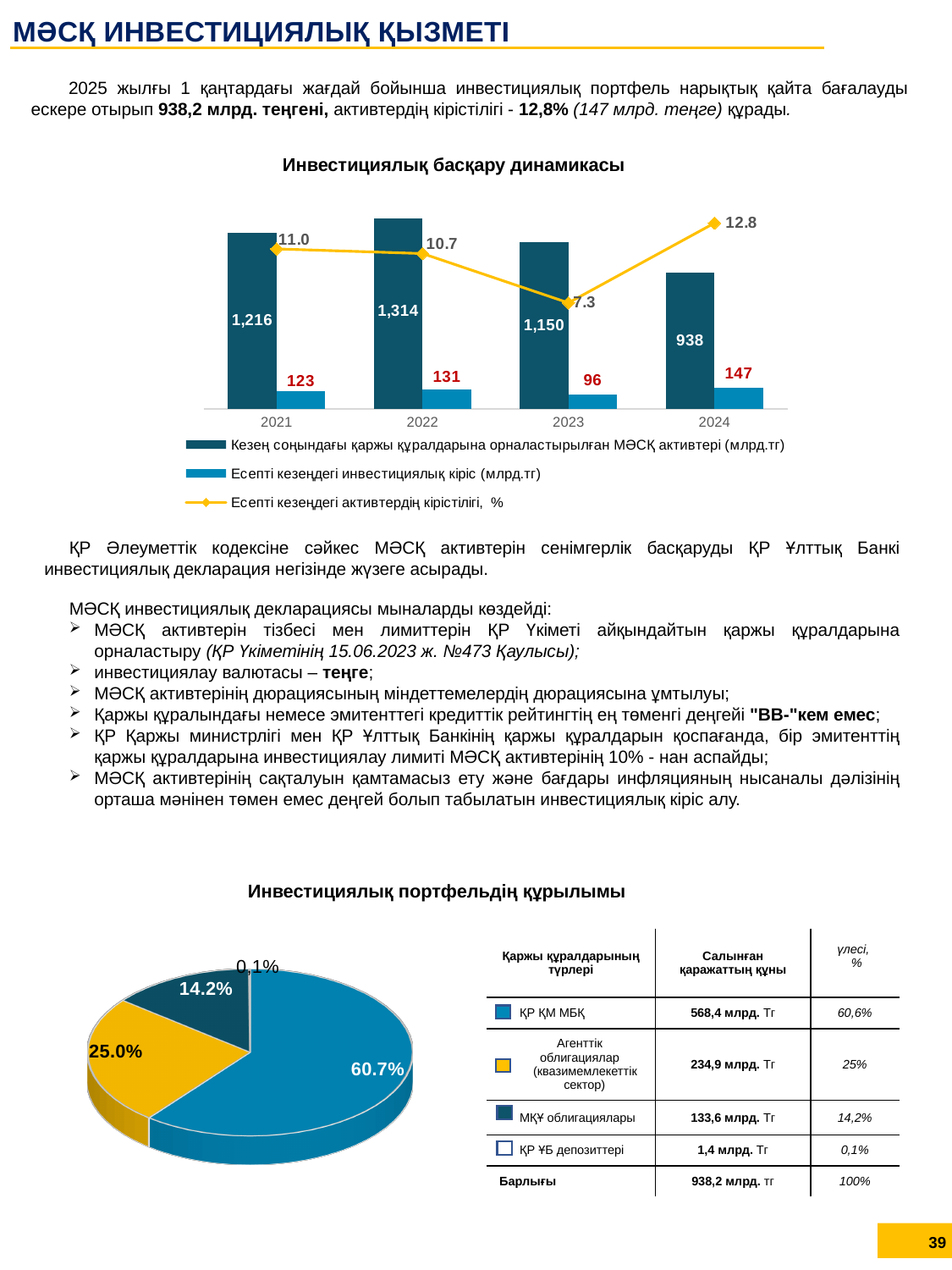
In the 'Инвестициялық басқару динамикасы' chart, what is the return on assets (%) shown on the line for 2023? 7.3 In the 'Инвестициялық басқару динамикасы' chart, which year has the larger investment income: 2021 or 2023? 2021 In the 'Инвестициялық басқару динамикасы' chart, which year has the highest value for МӘСҚ активтері? 2022 In the 'Инвестициялық басқару динамикасы' chart, which year has the lowest investment income (инвестициялық кіріс)? 2023 In the 'Инвестициялық басқару динамикасы' chart, what is the difference between the МӘСҚ активтері values for 2022 and 2024? 376 In the 'Инвестициялық басқару динамикасы' chart, how many years are shown on the x axis? 4 In the 'Инвестициялық басқару динамикасы' chart, how many series does the legend list? 3 In the 'Инвестициялық басқару динамикасы' chart, what is the value of the dark bar (МӘСҚ активтері, млрд.тг) for 2022? 1,314 In the 'Инвестициялық портфельдің құрылымы' pie chart, what share does the largest slice have? 60.7% In the 'Инвестициялық басқару динамикасы' chart, does the return on assets (%) line rise or fall from 2022 to 2023? fall In the 'Инвестициялық басқару динамикасы' chart, what is the investment income (инвестициялық кіріс, млрд.тг) for 2024? 147 What kind of chart is the 'Инвестициялық портфельдің құрылымы' chart? pie chart